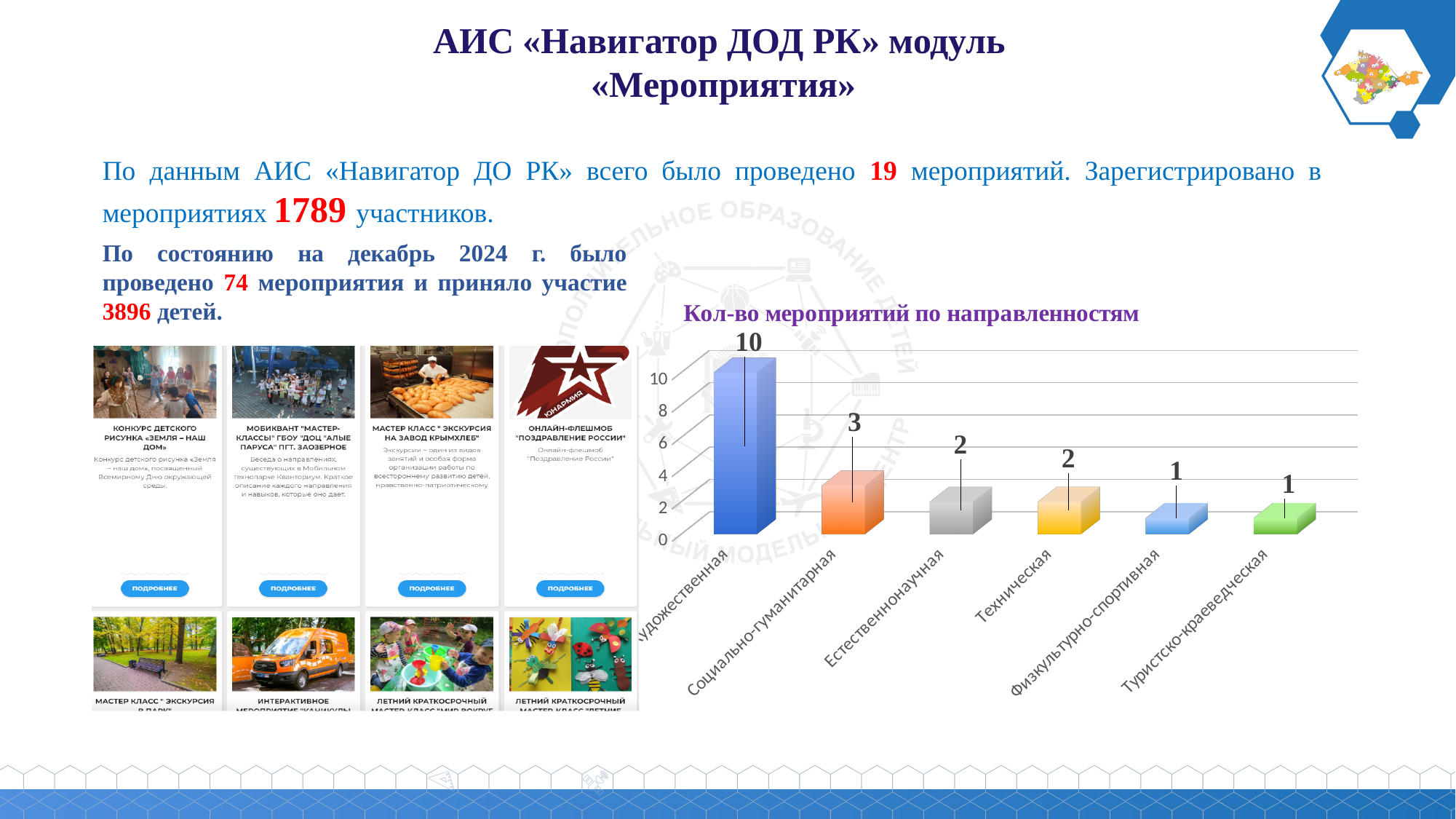
Do the values in the chart rise or fall from left to right along the x axis? fall What is the value for Социально-гуманитарная in the chart «Кол-во мероприятий по направленностям»? 3 Is the value for Художественная greater or less than 8? greater What is the value for Туристско-краеведческая in the chart? 1 What is the title of the chart on the slide? Кол-во мероприятий по направленностям How many events are shown for Техническая in the chart? 2 What kind of chart is «Кол-во мероприятий по направленностям»? bar chart What is the difference between the values for Художественная and Социально-гуманитарная? 7 How many categories are shown in the chart «Кол-во мероприятий по направленностям»? 6 What is the value for Физкультурно-спортивная in the chart? 1 Which category has the highest value in the chart «Кол-во мероприятий по направленностям»? Художественная Which is larger in the chart: the value for Социально-гуманитарная or the value for Естественнонаучная? Социально-гуманитарная